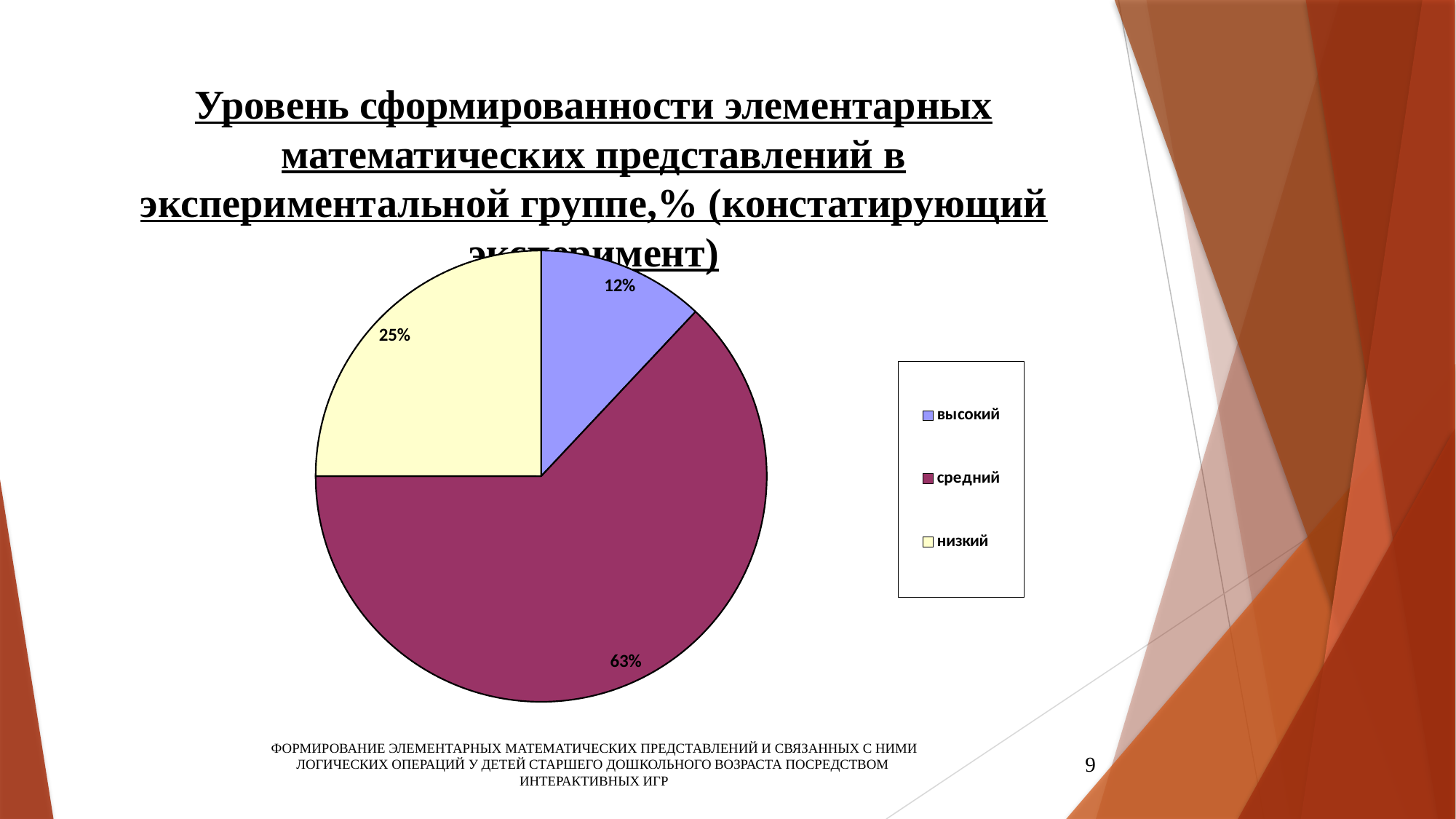
Which level has the smallest share of the pie? высокий What percentage is shown for the 'средний' slice? 63% What type of chart is shown on the slide? pie chart Which level has the largest share of the pie? средний What is the difference in percentage points between the 'низкий' and 'высокий' slices? 13 What percentage is shown for the 'низкий' slice? 25% What colour is the 'средний' slice? purple Which slice is larger, 'низкий' or 'высокий'? низкий What is the difference in percentage points between the 'средний' and 'низкий' slices? 38 What percentage is shown for the 'высокий' slice? 12% How many entries does the legend list? 3 How many slices does the pie chart have? 3